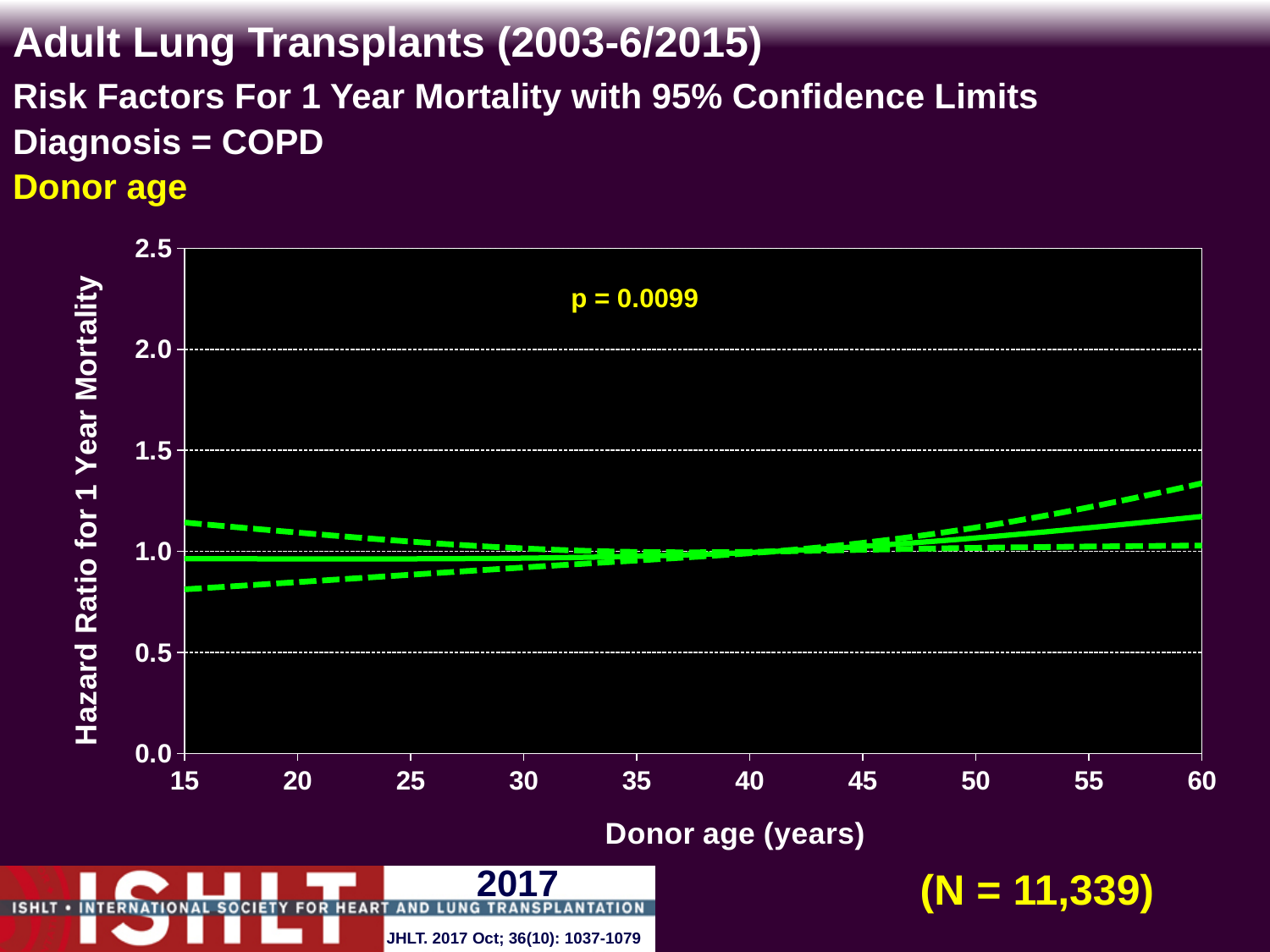
Is the upper 95% confidence limit at donor age 15 years greater or less than 1.0? greater What sample size (N) is shown on the slide? N = 11,339 Does the hazard ratio for 1 year mortality rise or fall as donor age increases from 15 to 60 years? rise What p-value is printed on the chart? p = 0.0099 Is the lower 95% confidence limit at donor age 15 years greater or less than 1.0? less How many lines (estimate plus confidence limits) are plotted on the chart? 3 What kind of chart is shown on the slide? line chart Is the lower 95% confidence limit at donor age 15 years greater or less than 0.5? greater Is the hazard ratio (solid line) higher at donor age 60 years or at donor age 15 years? 60 years